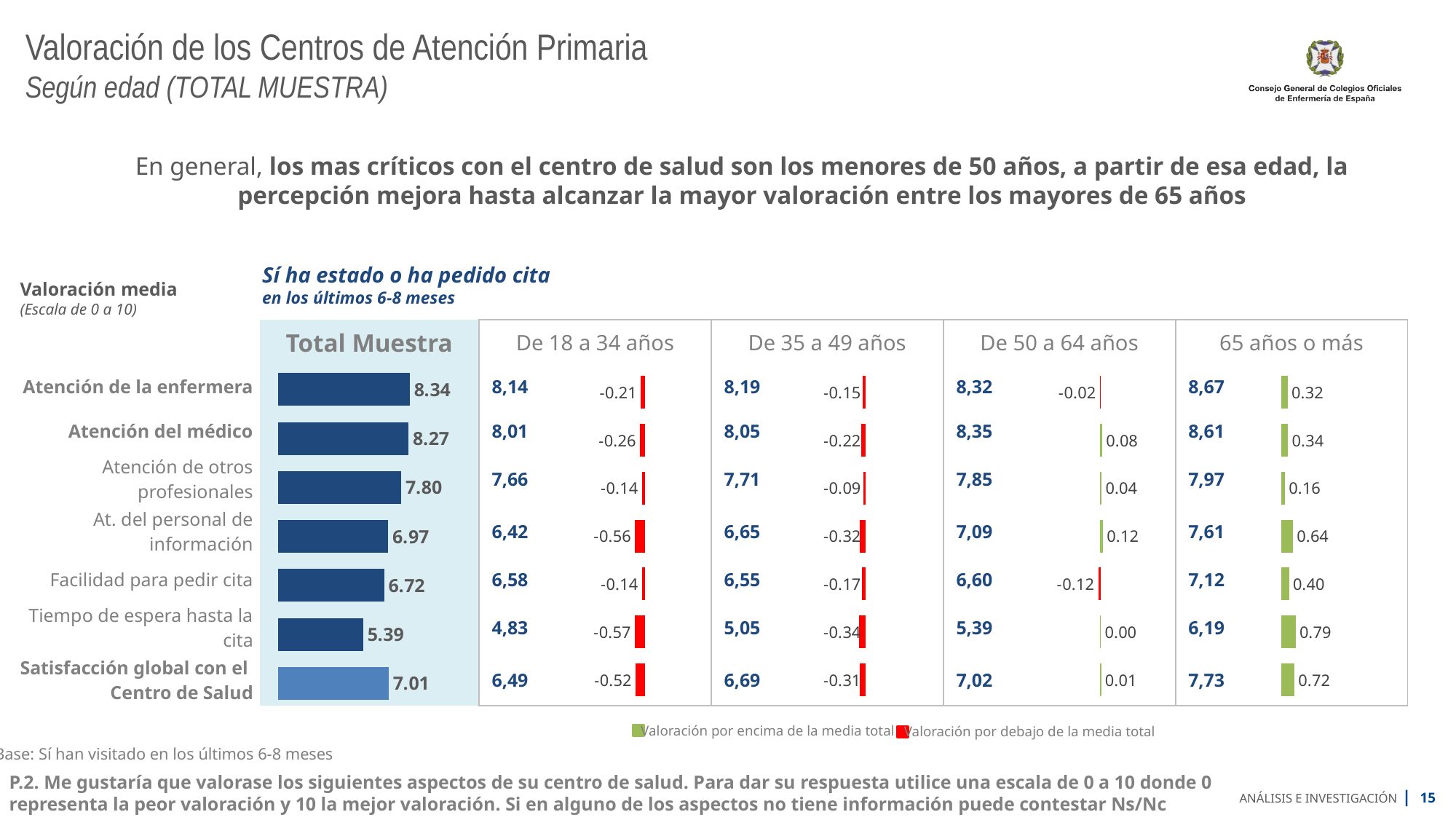
What is the value for Satisfacción global con el Centro de Salud in the 65 años o más column? 7,73 In the Total Muestra bar chart, which category has the lowest value? Tiempo de espera hasta la cita In the Total Muestra bar chart, what is the value for Tiempo de espera hasta la cita? 5.39 What kind of chart is used for the Total Muestra column? Bar chart According to the legend, what does a green bar indicate? Valoración por encima de la media total How many categories does the Total Muestra bar chart show? 7 In the Total Muestra bar chart, which is larger: Facilidad para pedir cita or Satisfacción global con el Centro de Salud? Satisfacción global con el Centro de Salud What is the value for Tiempo de espera hasta la cita in the De 18 a 34 años column? 4,83 What is the deviation from the total mean shown for At. del personal de información in the De 18 a 34 años column? -0.56 In the Total Muestra bar chart, what is the value for Atención de la enfermera? 8.34 In the Total Muestra bar chart, which category has the highest value? Atención de la enfermera In the Total Muestra bar chart, what is the difference between Atención de la enfermera and Atención del médico? 0.07